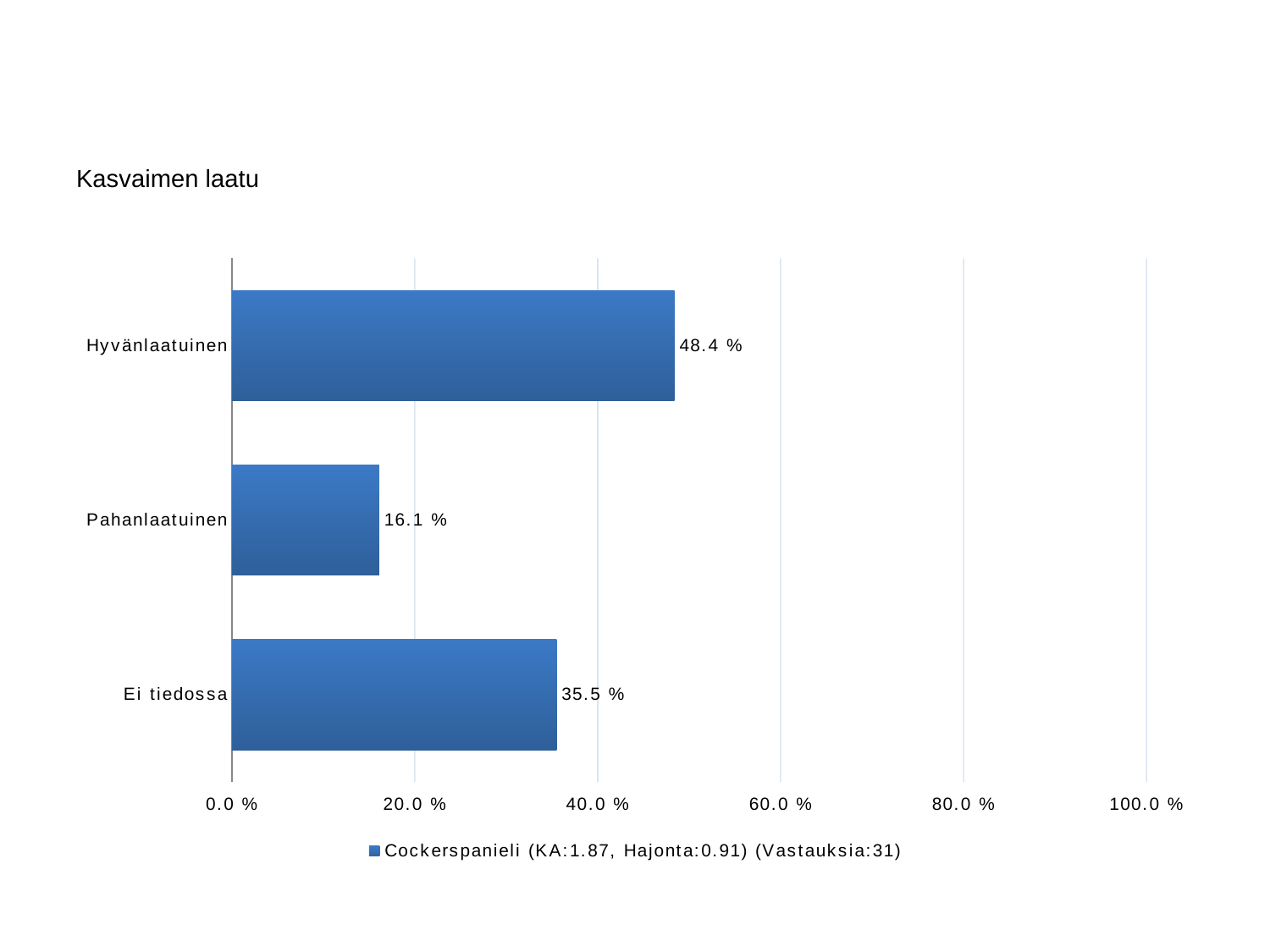
What kind of chart is shown on the slide? bar chart What is the value for Ei tiedossa? 35.5 % How many categories are shown in the chart? 3 What is the title of the chart? Kasvaimen laatu Which is larger, the value for Ei tiedossa or the value for Pahanlaatuinen? Ei tiedossa What is the value for Pahanlaatuinen? 16.1 % Which category has the lowest value? Pahanlaatuinen What is the difference between the values for Ei tiedossa and Pahanlaatuinen? 19.4 % What is the value for Hyvänlaatuinen? 48.4 % Is the value for Hyvänlaatuinen greater or less than 40.0 %? greater Which category has the highest value? Hyvänlaatuinen What is the difference between the values for Hyvänlaatuinen and Pahanlaatuinen? 32.3 %